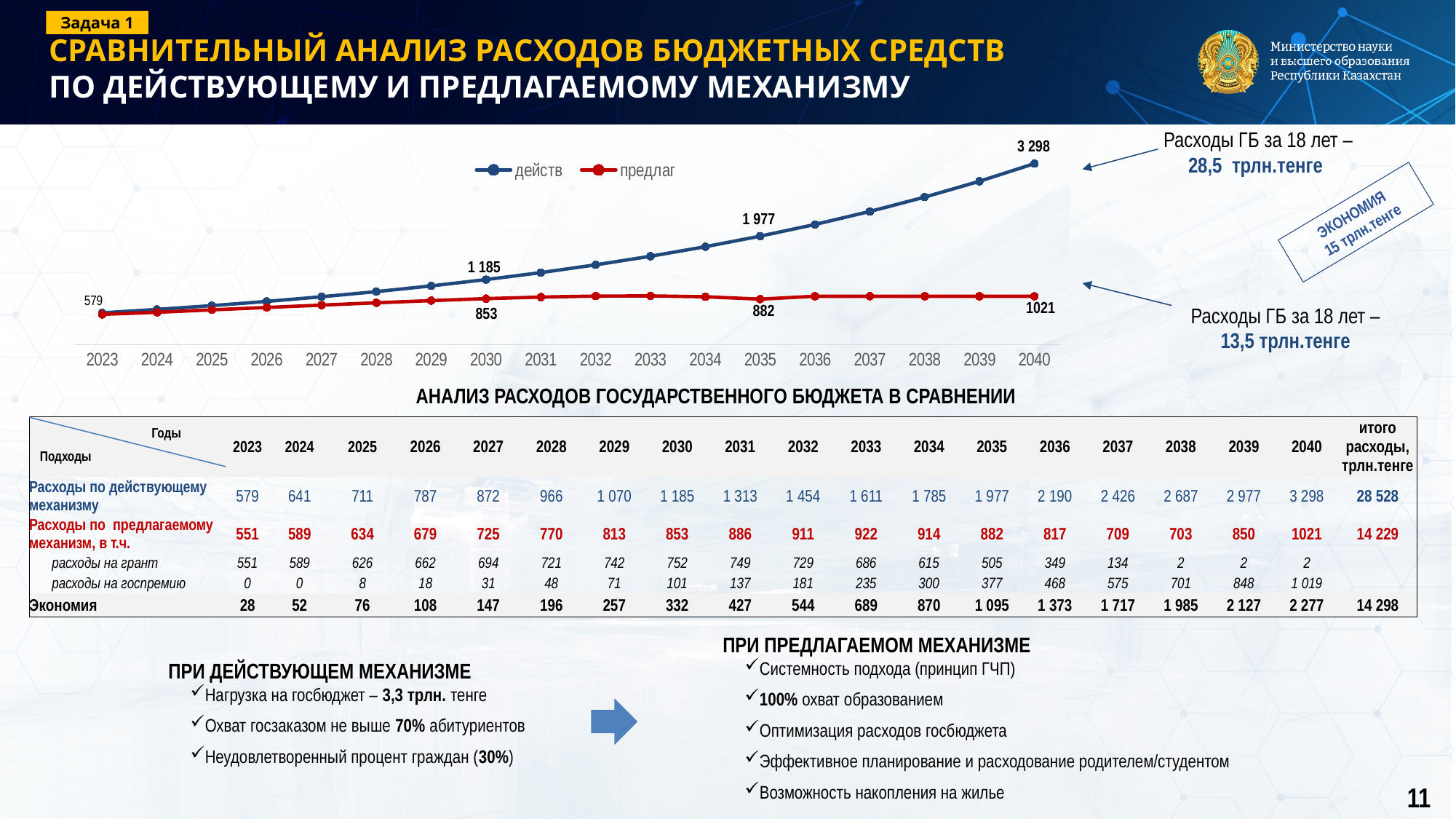
What kind of chart is shown at the top of the slide? line chart Does the действ series rise or fall from 2023 to 2040? rise What is the value of the действ series in 2040 according to the chart's data label? 3 298 Which series has the larger value in 2040, действ or предлаг? действ What is the value of the предлаг series in 2030 according to the chart's data label? 853 What is the value of the предлаг series in 2040 according to the chart's data label? 1021 In which year does the действ series reach its highest value on the chart? 2040 What is the difference between the действ and предлаг values in 2035 as labelled on the chart? 1 095 What are the two series named in the chart legend? действ and предлаг What is the value of the действ series in 2035 according to the chart's data label? 1 977 How many series does the chart legend list? 2 How many years are shown on the x axis of the chart? 18